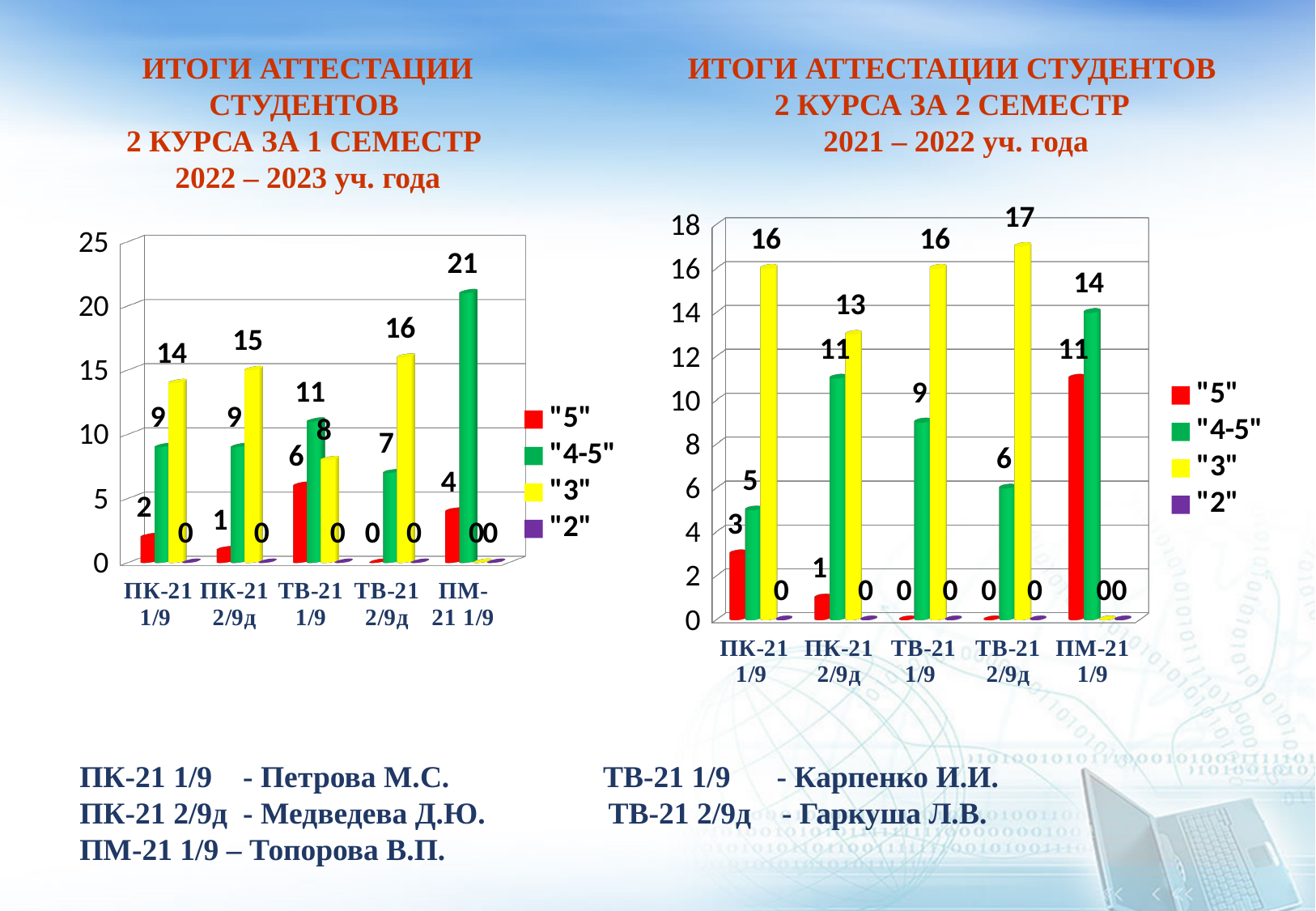
In the left chart (1 семестр 2022–2023), what is the value of "3" for ТВ-21 2/9д? 16 In the right chart (2 семестр 2021–2022), what is the total of the "5", "4-5", "3" and "2" values for ПК-21 1/9? 24 In the right chart (2 семестр 2021–2022), what is the value of "5" for ПМ-21 1/9? 11 In the left chart (1 семестр 2022–2023), how many groups are shown on the x axis? 5 In the right chart (2 семестр 2021–2022), which is larger: the "4-5" value for ПК-21 2/9д or for ТВ-21 1/9? ПК-21 2/9д In the left chart (1 семестр 2022–2023), what is the difference between the "3" values for ПК-21 2/9д and ТВ-21 1/9? 7 What type of chart is the left chart? Bar chart In the left chart (1 семестр 2022–2023), what is the value of "4-5" for ПМ-21 1/9? 21 In the right chart (2 семестр 2021–2022), what is the value of "3" for ТВ-21 2/9д? 17 In the right chart (2 семестр 2021–2022), which group has the lowest value for "4-5"? ПК-21 1/9 In the left chart (1 семестр 2022–2023), which group has the highest value for "5"? ТВ-21 1/9 How many series does the legend of the right chart list? 4